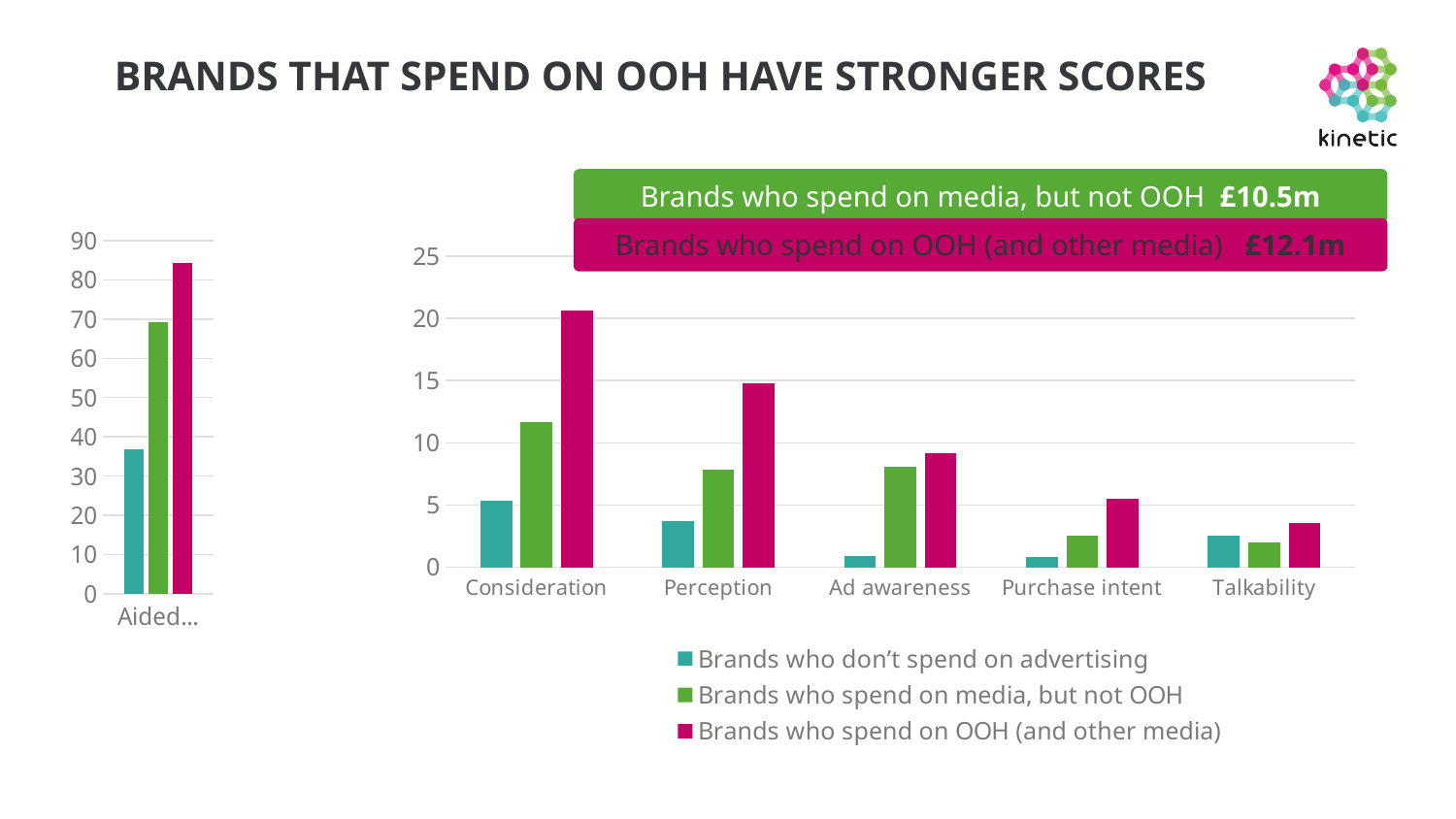
In the large chart on the right, which category has the highest value for 'Brands who spend on OOH (and other media)'? Consideration In the small chart on the left, is the value of the magenta bar greater or less than 80? greater In the large chart on the right, is the Consideration value for 'Brands who spend on OOH (and other media)' greater or less than 15? greater In the large chart on the right, is the Ad awareness value for 'Brands who don't spend on advertising' greater or less than 5? less In the large chart on the right, which is larger for 'Brands who spend on media, but not OOH': Consideration or Perception? Consideration What kind of chart is the large chart on the right of the slide? bar chart In the large chart on the right, how many categories are shown on the x axis? 5 In the large chart on the right, how many series does the legend list? 3 In the large chart on the right, which series is drawn in magenta? Brands who spend on OOH (and other media) In the large chart on the right, which category has the lowest value for 'Brands who spend on OOH (and other media)'? Talkability